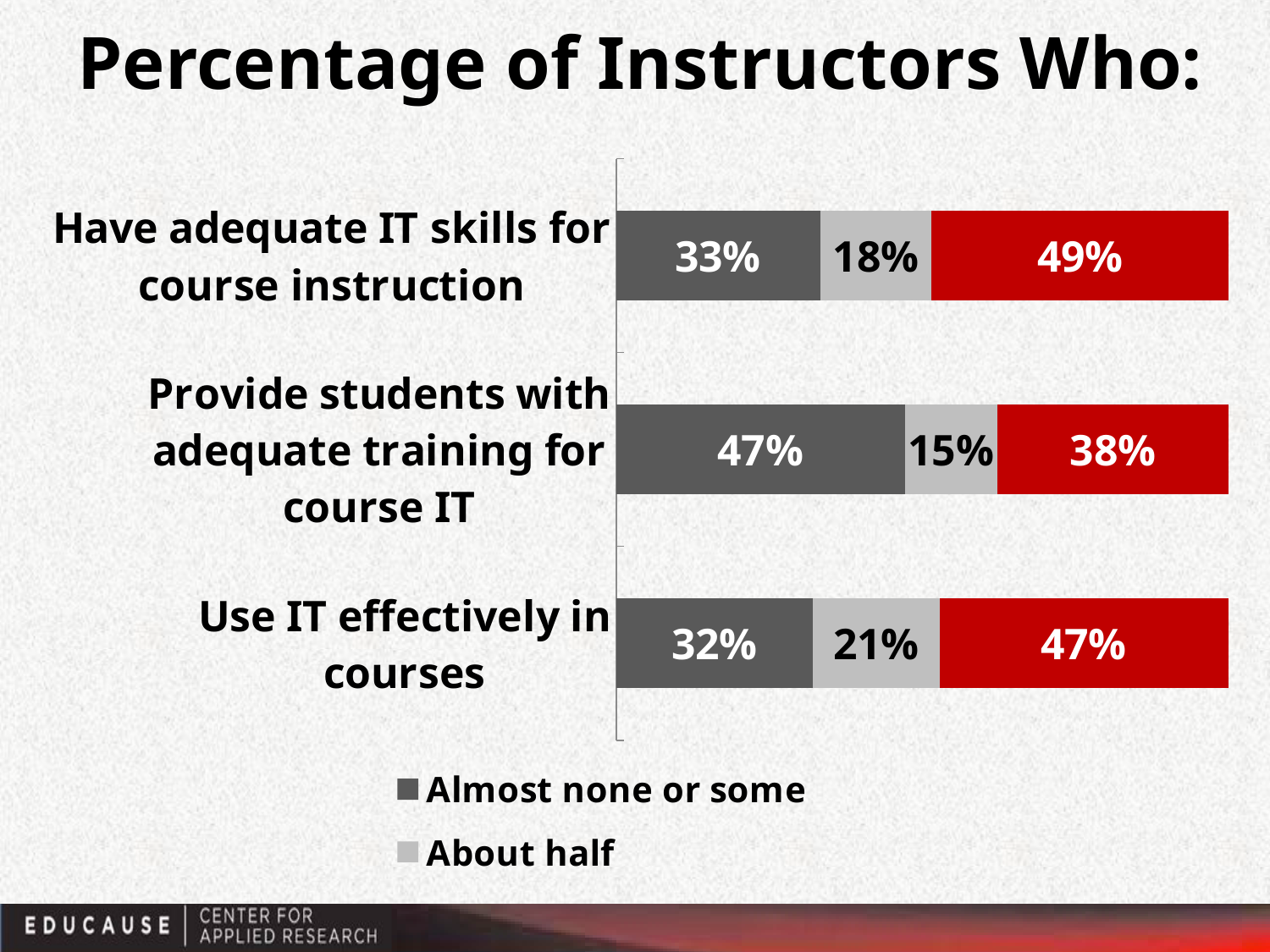
Which category has the highest "Almost none or some" value? Provide students with adequate training for course IT What is the "About half" value for "Use IT effectively in courses"? 21% What is the "Almost none or some" value for "Use IT effectively in courses"? 32% How many categories are shown in the chart? 3 What kind of chart is shown on the slide? Stacked bar chart What percentage of instructors answered "Almost none or some" for "Have adequate IT skills for course instruction"? 33% Which category has the lowest "About half" value? Provide students with adequate training for course IT What is the difference between the "Almost none or some" values for "Provide students with adequate training for course IT" and "Have adequate IT skills for course instruction"? 14 percentage points Which has the larger "About half" value: "Use IT effectively in courses" or "Have adequate IT skills for course instruction"? Use IT effectively in courses What is the total of the stacked bar for "Have adequate IT skills for course instruction"? 100% What is the "About half" value for "Provide students with adequate training for course IT"? 15% What is the title of the slide? Percentage of Instructors Who: